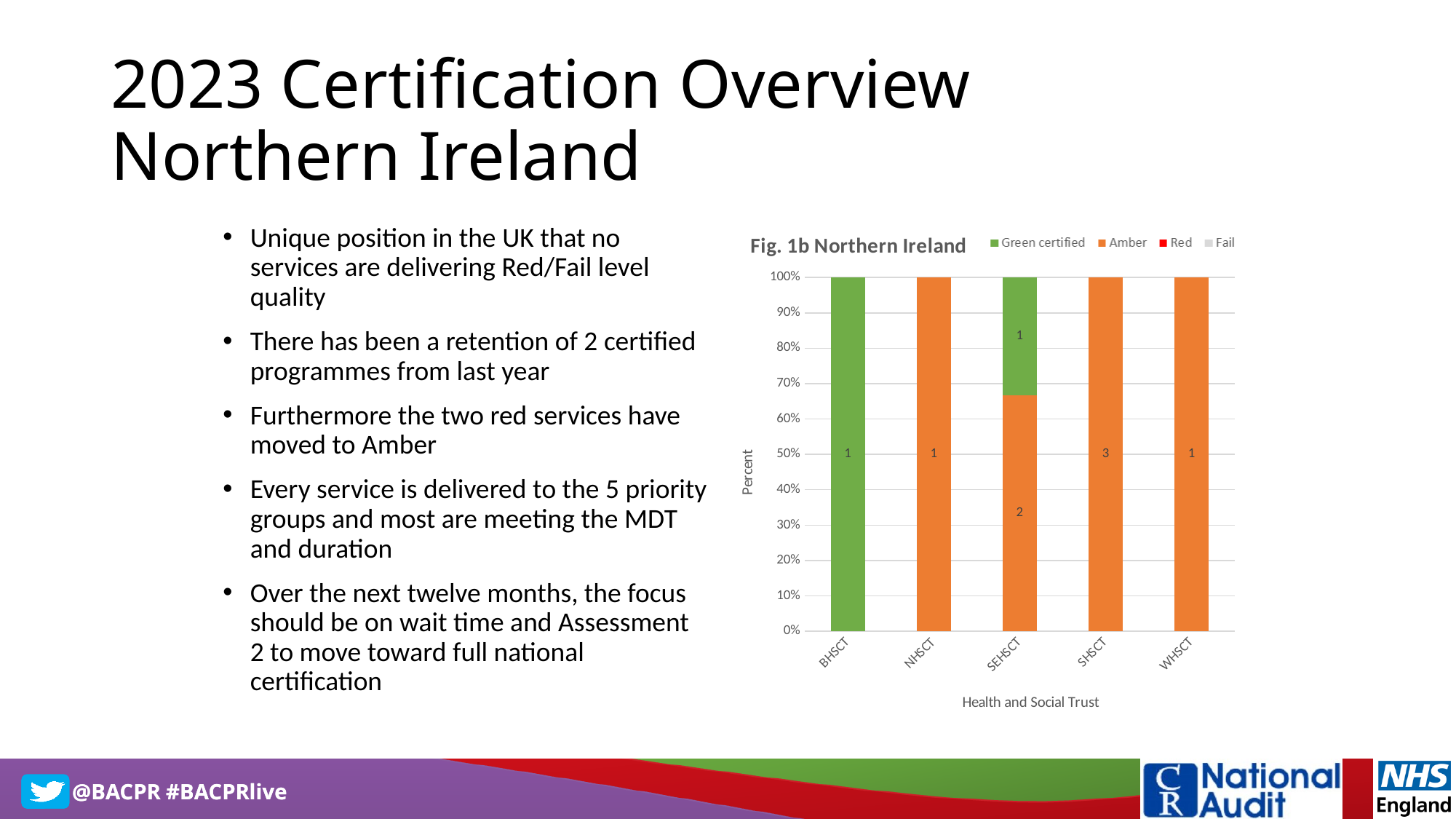
What is the Green certified value labelled for SEHSCT? 1 What is the label on the y axis of the chart? Percent What is the Amber value labelled for SEHSCT? 2 How many series does the chart legend list? 4 Is the Amber share of the SEHSCT bar greater or less than 60%? greater What is the Amber value labelled for SHSCT? 3 How many Health and Social Trusts are shown on the x axis of the chart? 5 What is the total number of services labelled in the SEHSCT bar? 3 What is the title of the chart? Fig. 1b Northern Ireland What type of chart is shown in Fig. 1b Northern Ireland? Stacked bar chart What is the Green certified value labelled for BHSCT? 1 Which trust has the highest Amber value? SHSCT